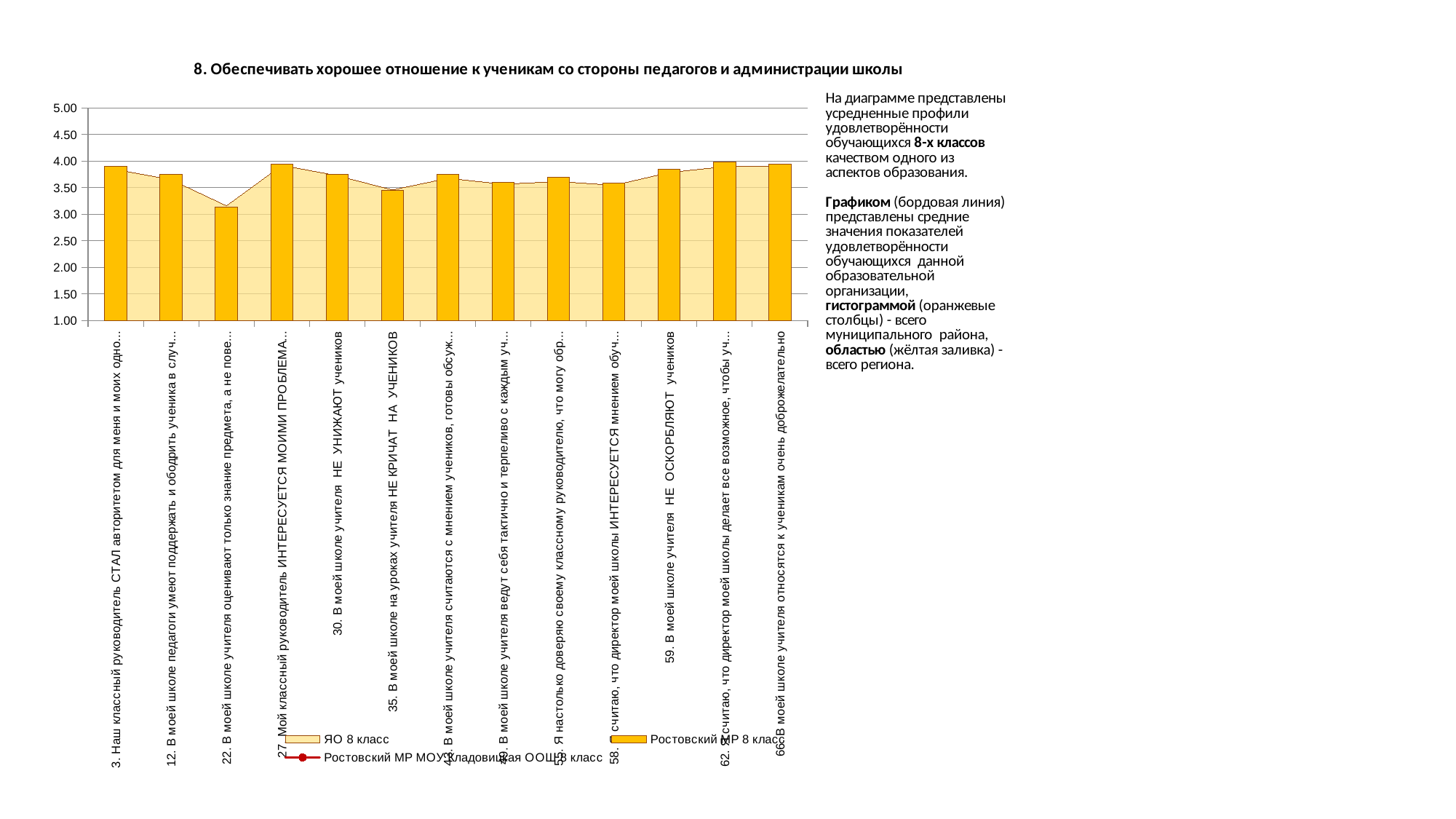
Which has the larger 'Ростовский МР 8 класс' bar: statement 35 or statement 66? statement 66 What is the maximum value shown on the vertical axis? 5.00 How many categories (statements) are plotted along the x axis? 13 Is the 'Ростовский МР 8 класс' bar for statement 59 ('В моей школе учителя НЕ ОСКОРБЛЯЮТ учеников') greater or less than 3.50? greater Is the 'Ростовский МР 8 класс' bar for statement 22 greater or less than 3.00? greater What is the title of the chart? 8. Обеспечивать хорошее отношение к ученикам со стороны педагогов и администрации школы Which has the larger 'Ростовский МР 8 класс' bar: statement 22 or statement 30? statement 30 Which category has the lowest bar for 'Ростовский МР 8 класс'? 22. В моей школе учителя оценивают только знание предмета, а не пове… What kind of chart is used for the series 'Ростовский МР 8 класс'? bar chart Is the 'Ростовский МР 8 класс' bar for statement 22 greater or less than 3.50? less How many series does the chart legend list? 3